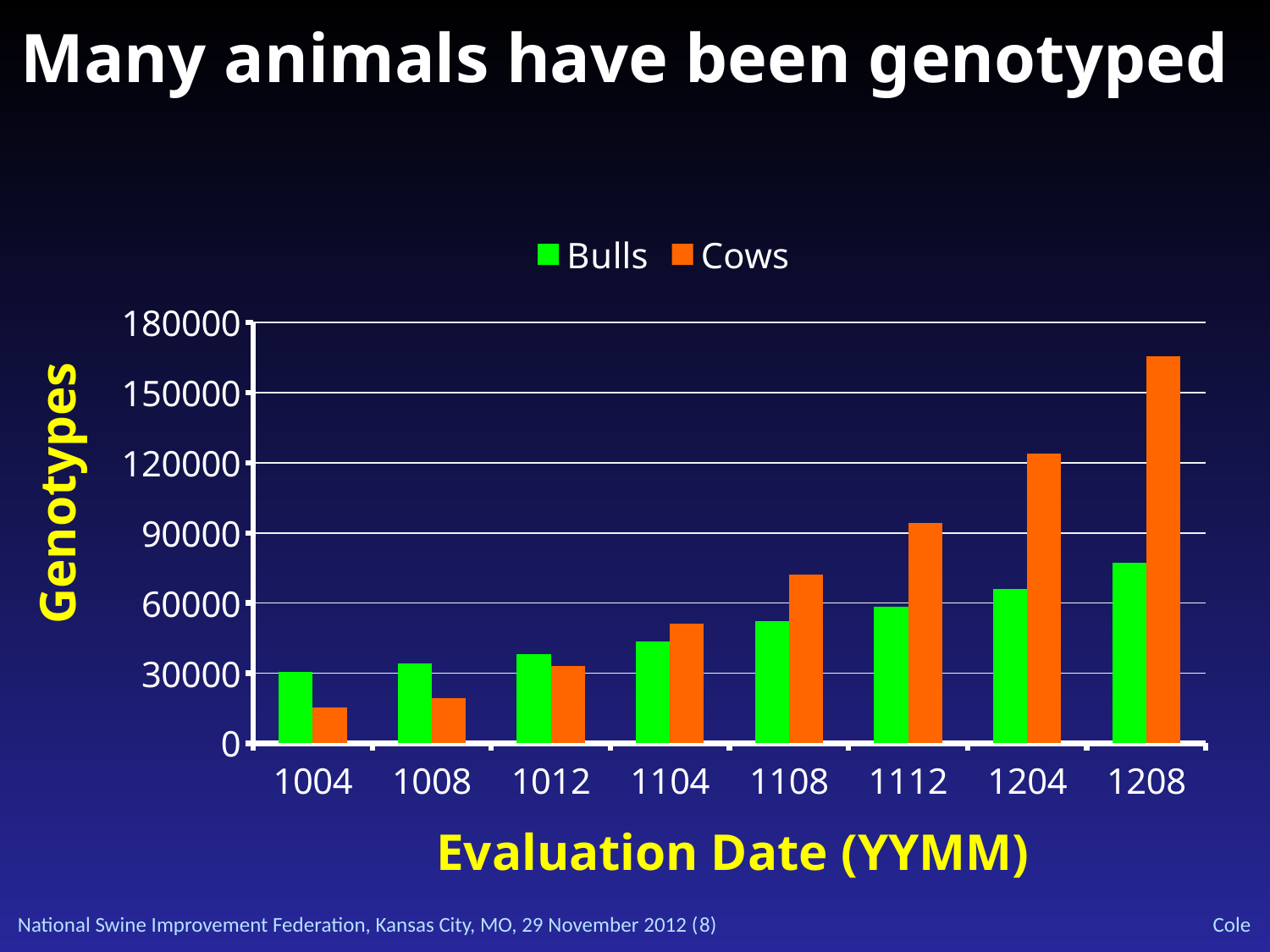
How many evaluation dates are shown on the x axis? 8 How many series does the legend list? 2 Is the value for Bulls at 1208 greater or less than 60000? greater Is the value for Cows at 1004 greater or less than 30000? less Which evaluation date has the lowest value for Cows? 1004 Do the values for Cows rise or fall from 1004 to 1208? rise Which evaluation date has the highest value for Cows? 1208 Is the value for Cows at 1208 greater or less than 150000? greater At evaluation date 1004, which is larger, Bulls or Cows? Bulls At evaluation date 1208, which is larger, Bulls or Cows? Cows What kind of chart is shown on the slide? bar chart